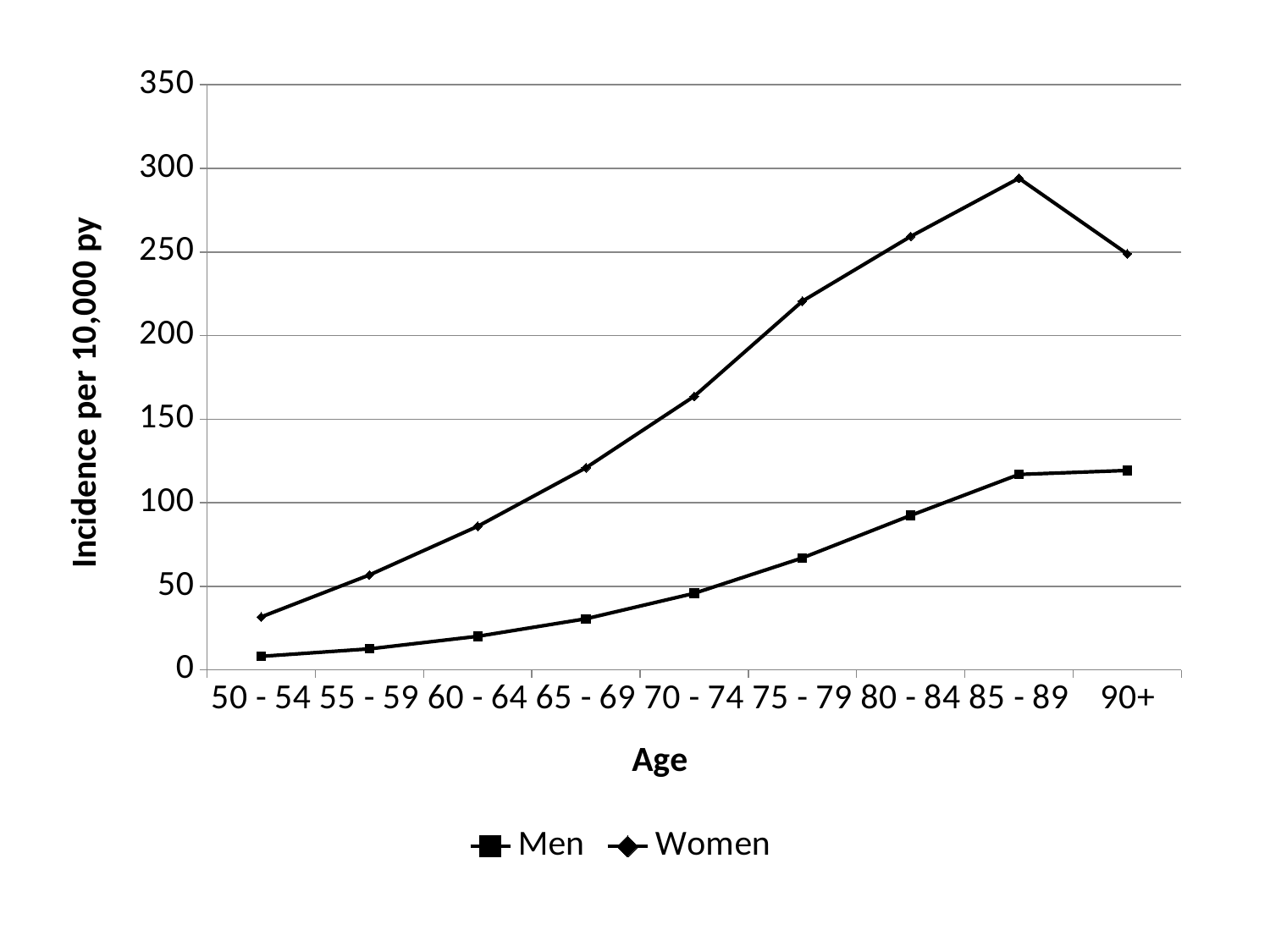
Which series has the larger value in the 70 - 74 age group, Men or Women? Women Is the value for Women in the 85 - 89 age group greater or less than 250? greater Does the Men series generally rise or fall as age increases along the x axis? rise How many age groups are plotted along the x axis? 9 Is the value for Women in the 75 - 79 age group greater or less than 200? greater Which age group has the lowest incidence for Men? 50 - 54 Which age group has the lowest incidence for Women? 50 - 54 What kind of chart is shown on the slide? line chart Is the value for Men in the 80 - 84 age group greater or less than 100? less Which age group has the highest incidence for Women? 85 - 89 How many series does the legend list? 2 What is the title of the y axis? Incidence per 10,000 py